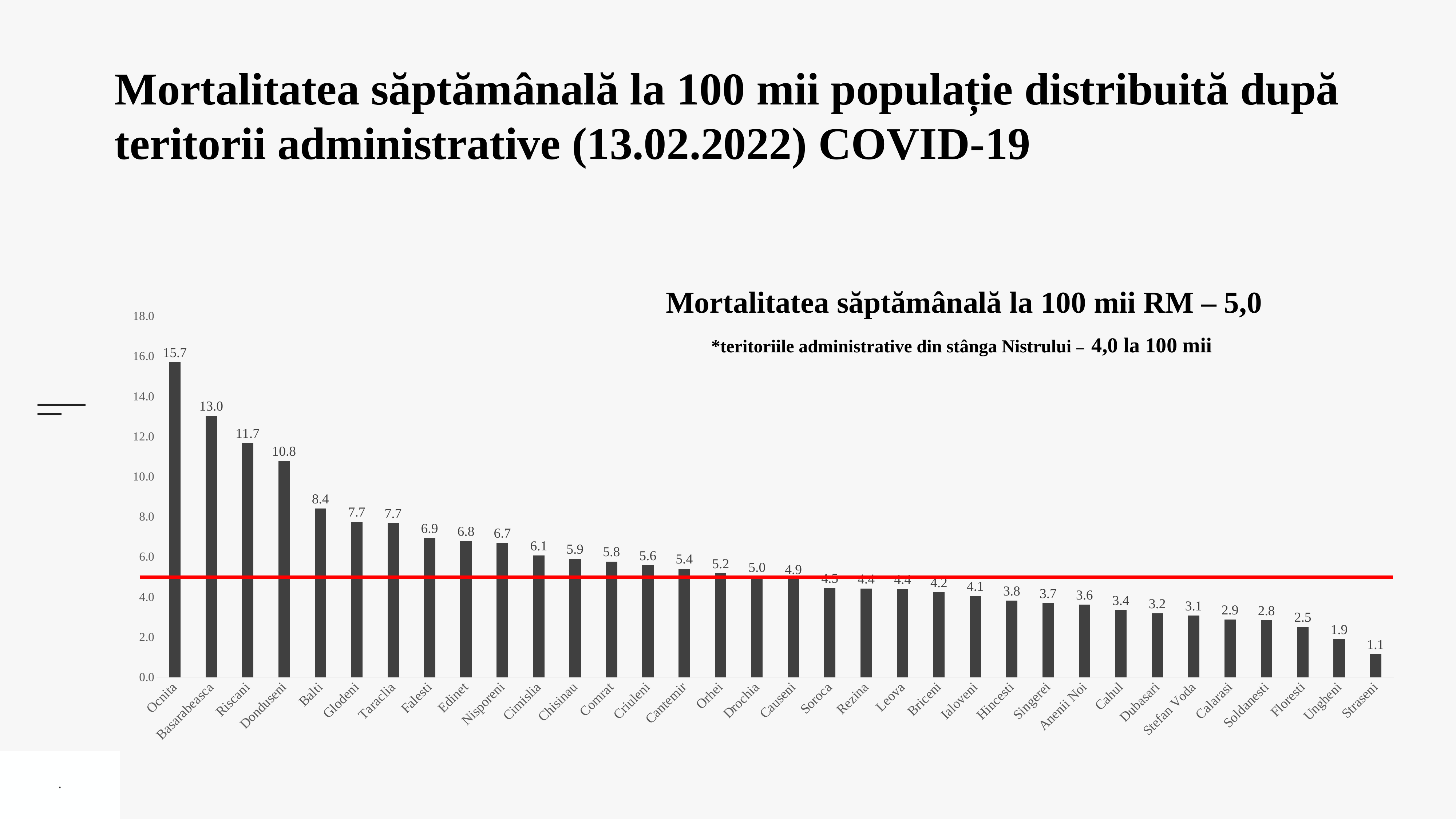
What type of chart is shown on the slide? bar chart Which administrative territory has the highest weekly mortality per 100 thousand? Ocnita What is the value shown for Balti? 8.4 What is the value shown for Cahul? 3.4 Do the values rise or fall moving from left to right along the x axis? fall Which administrative territory has the lowest weekly mortality per 100 thousand? Straseni How many administrative territories are shown on the x axis of the chart? 34 What is the difference between the values for Ocnita and Basarabeasca? 2.7 What is the difference between the values for Riscani and Donduseni? 0.9 Which has a higher value, Edinet or Cimislia? Edinet What is the weekly mortality value shown for Chisinau? 5.9 Is the value for Glodeni greater or less than 6.0? greater